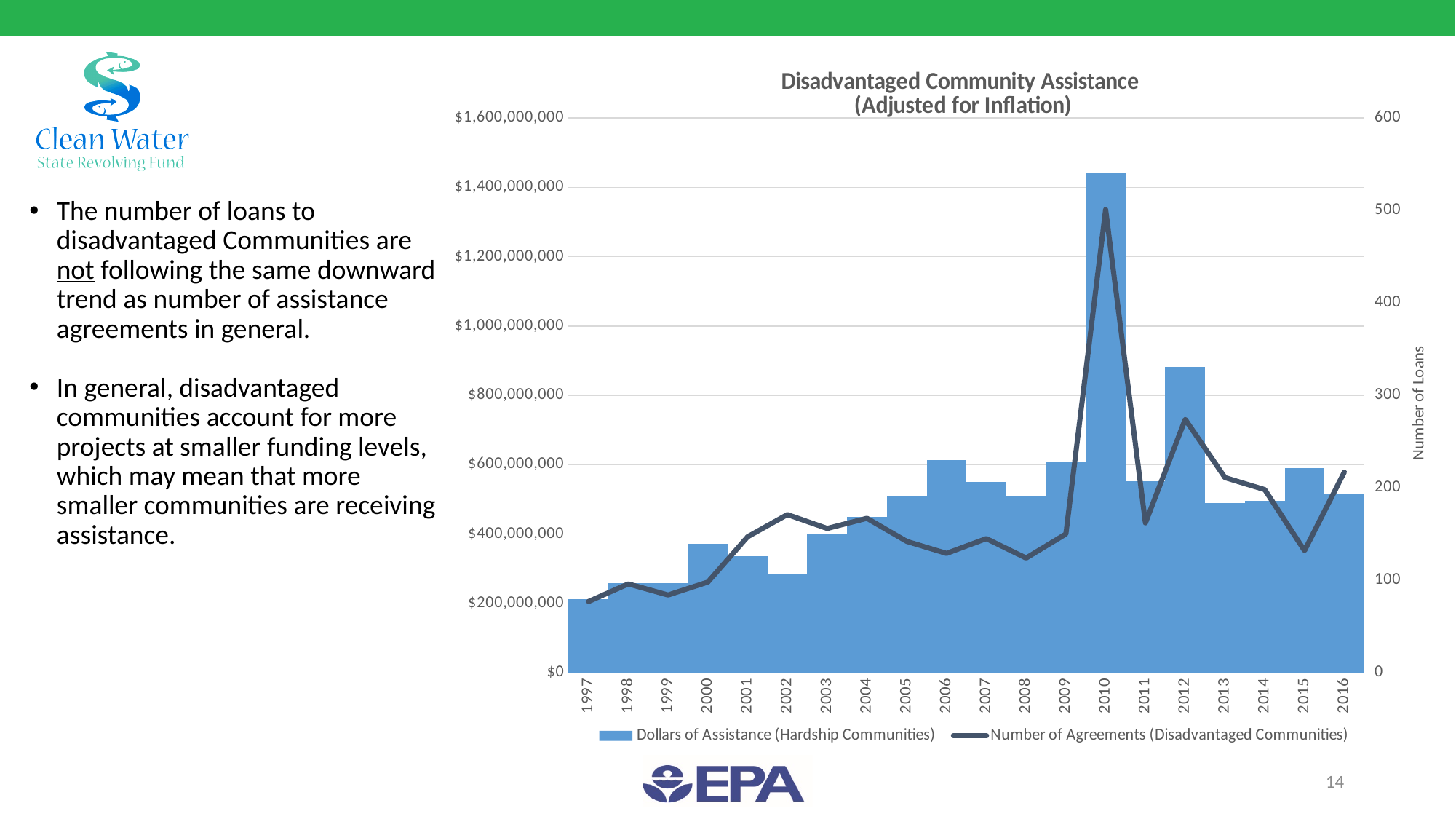
Is the Dollars of Assistance bar for 2010 greater or less than $1,200,000,000? greater Which year has the lowest bar for Dollars of Assistance (Hardship Communities)? 1997 Is the Number of Agreements value for 2015 greater or less than 200? less In which year does the Number of Agreements (Disadvantaged Communities) line reach its peak? 2010 Is the Dollars of Assistance bar for 2002 greater or less than $400,000,000? less How many series does the chart's legend list? 2 Do the Dollars of Assistance bars generally rise or fall from 1997 to 2006? rise What kind of chart is shown on the slide? A combination bar and line chart What is the title of the chart? Disadvantaged Community Assistance (Adjusted for Inflation) Which year has the larger Dollars of Assistance bar, 2012 or 2009? 2012 Which year has the highest bar for Dollars of Assistance (Hardship Communities)? 2010 How many years are shown along the x axis of the chart? 20